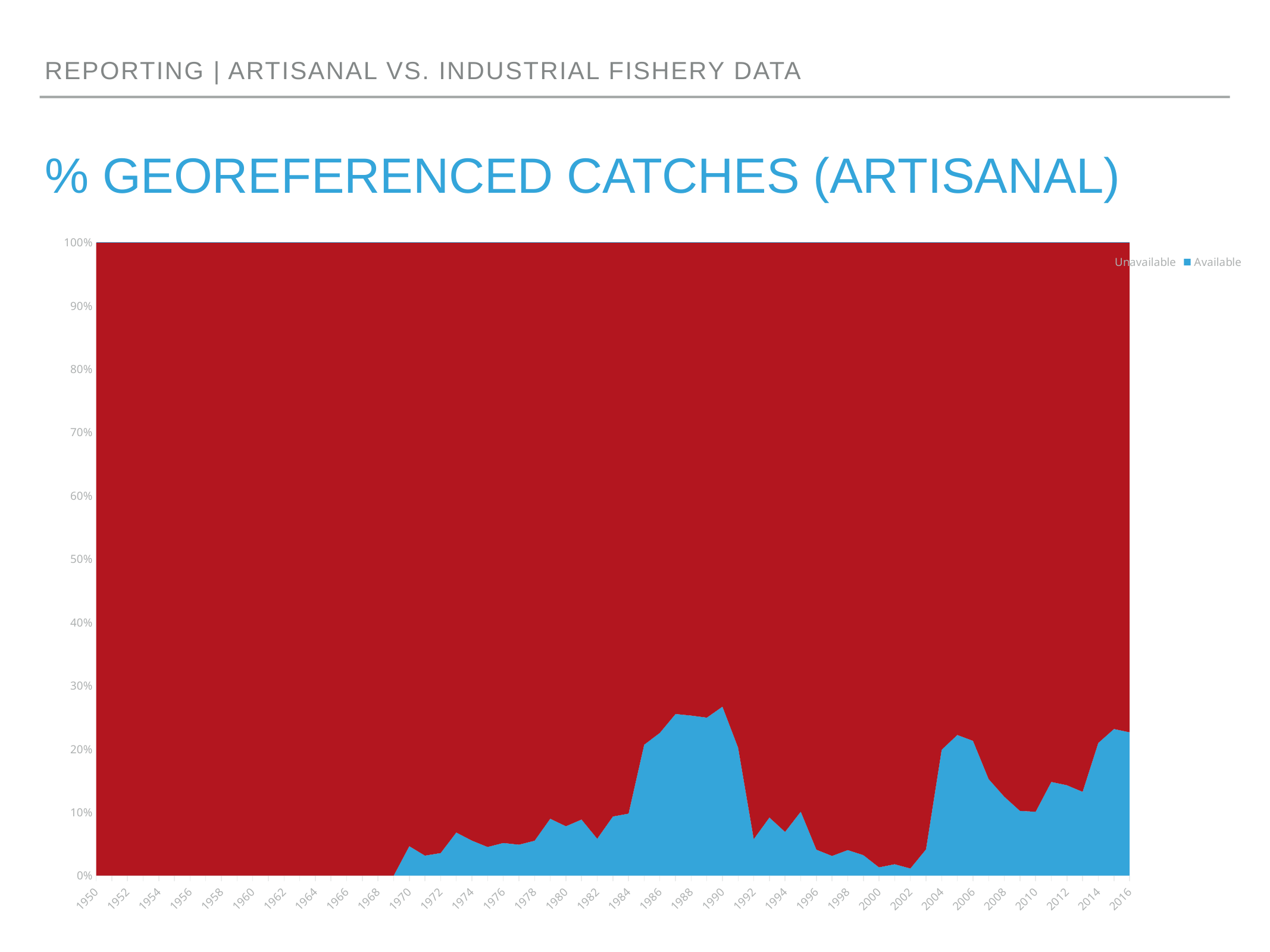
Which is larger, the Available value in 1988 or in 2000? 1988 What is the Available value in 1960? 0% Is the Available value in 1980 greater or less than 10%? less Which colour represents the Available series? Blue In 2016, which series is larger, Unavailable or Available? Unavailable Is the Available value in 1988 greater or less than 20%? greater How many series does the legend list? 2 Is the Unavailable value in 1988 greater or less than 70%? greater What are the two series named in the legend? Unavailable and Available What kind of chart is shown on the slide? Area chart Does the Available share generally rise or fall from 1950 to 2016? Rise